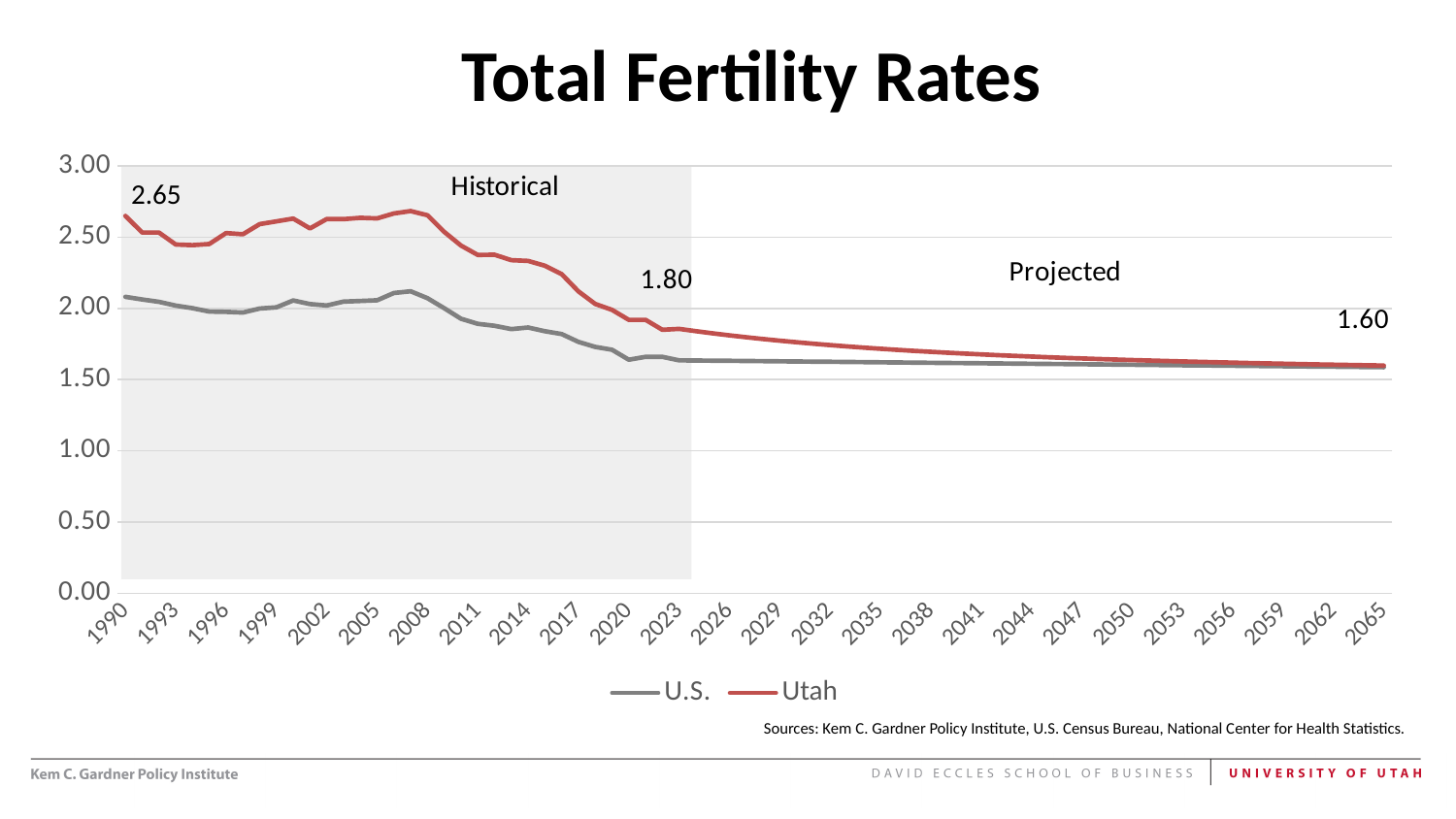
What is the labeled value for Utah at the end of the historical period, around 2023? 1.80 What kind of chart is shown on the slide? line chart What label is shown over the shaded region on the left side of the chart? Historical What is the difference between Utah's labeled 1990 value and its labeled value around 2023? 0.85 Is the value for the U.S. in 2020 greater or less than 2.00? less What is the labeled total fertility rate for Utah in 1990? 2.65 What is the labeled value at the end of the projection in 2065? 1.60 How many series does the legend list? 2 Does the Utah line generally rise or fall from 1990 to 2065? fall What are the two series named in the legend? U.S. and Utah What is the difference between the labeled 1990 Utah value and the labeled 2065 value? 1.05 In 1990, which series has the higher total fertility rate, U.S. or Utah? Utah